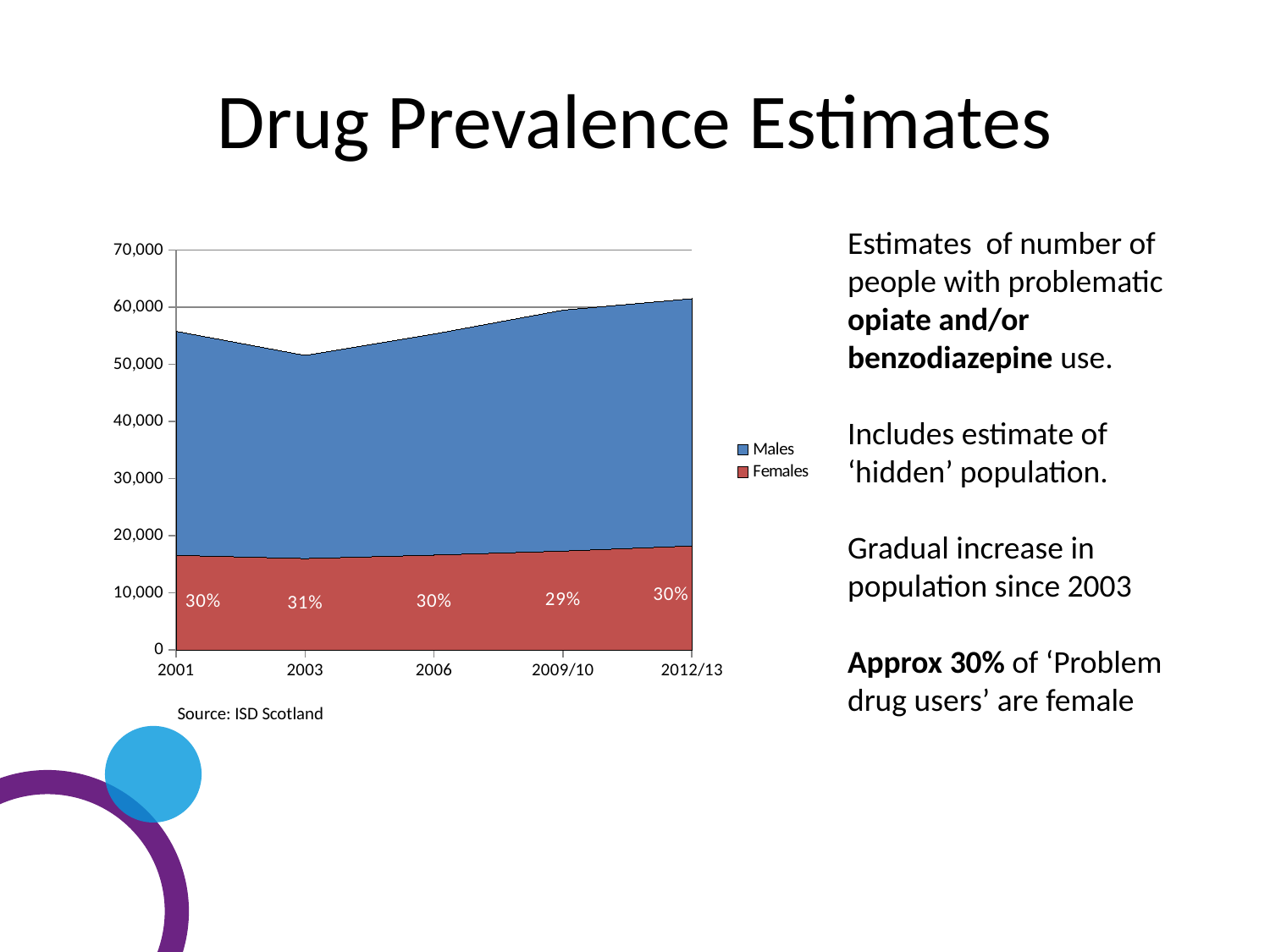
In which period is the total stacked value (Males plus Females) lowest? 2003 Which series is larger in 2001, Males or Females? Males In which period is the Females percentage label highest? 2003 In which period is the Females percentage label lowest? 2009/10 What percentage label is shown for Females in 2009/10? 29% Is the Females value for 2001 greater or less than 20,000? less What percentage label is shown for Females in 2012/13? 30% What kind of chart is shown on the slide? area chart What percentage label is shown for Females in 2003? 31% How many time periods are shown along the x axis of the chart? 5 How many series does the chart legend list? 2 Is the total stacked value for 2001 greater or less than 50,000? greater